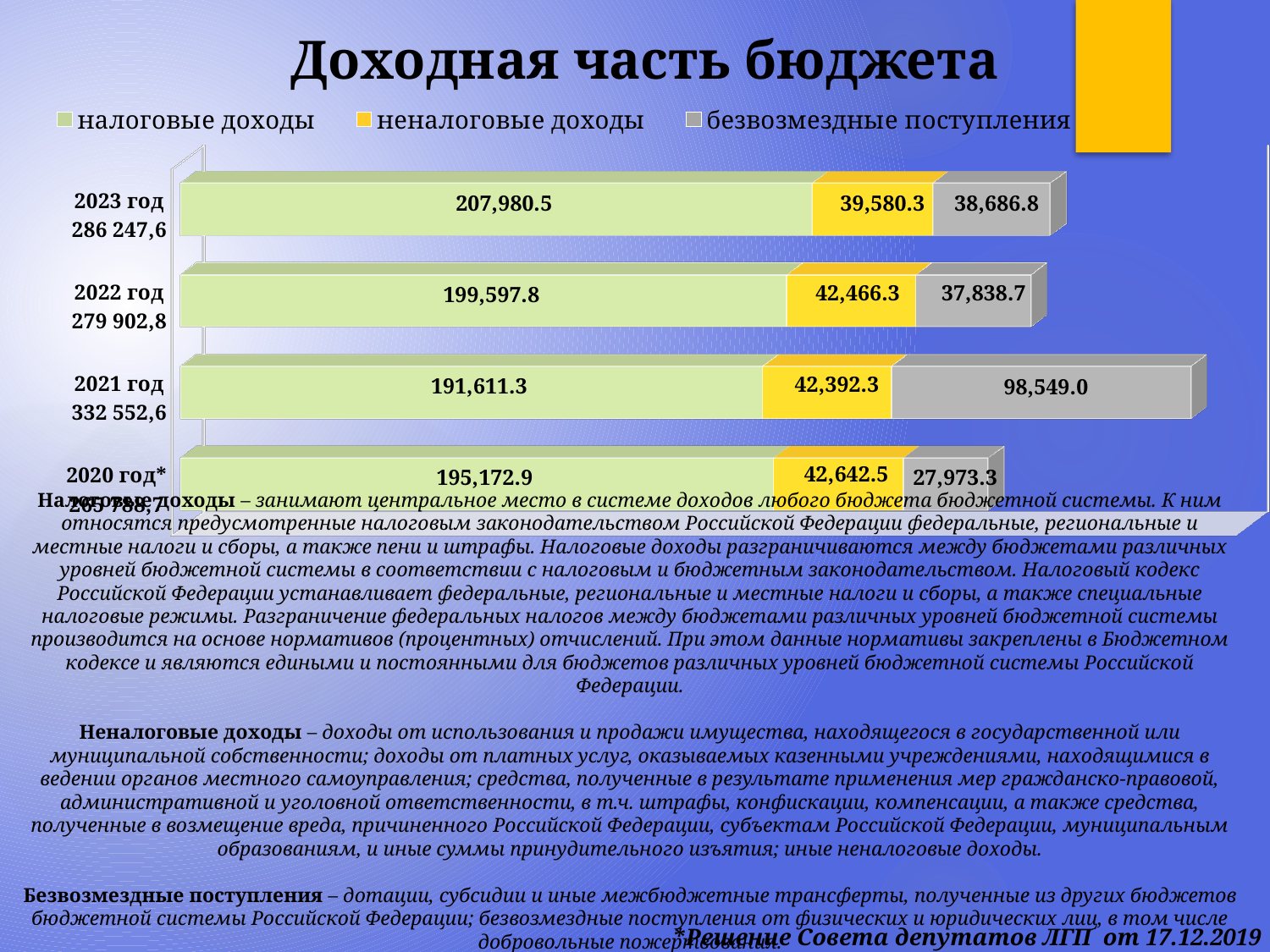
Which year has the highest value of налоговые доходы? 2023 год What is the value of неналоговые доходы for 2020 год*? 42,642.5 How many years are shown in the chart? 4 What is the difference between налоговые доходы in 2023 год and in 2022 год? 8,382.7 What is the value of безвозмездные поступления for 2021 год? 98,549.0 Which year has the lowest value of безвозмездные поступления? 2020 год* What kind of chart is shown on the slide? Stacked bar chart What is the difference between безвозмездные поступления in 2021 год and in 2020 год*? 70,575.7 What is the total of the stacked bar for 2021 год? 332 552,6 How many series does the legend list? 3 What is the value of налоговые доходы for 2023 год? 207,980.5 Which is larger: неналоговые доходы in 2022 год or in 2023 год? 2022 год